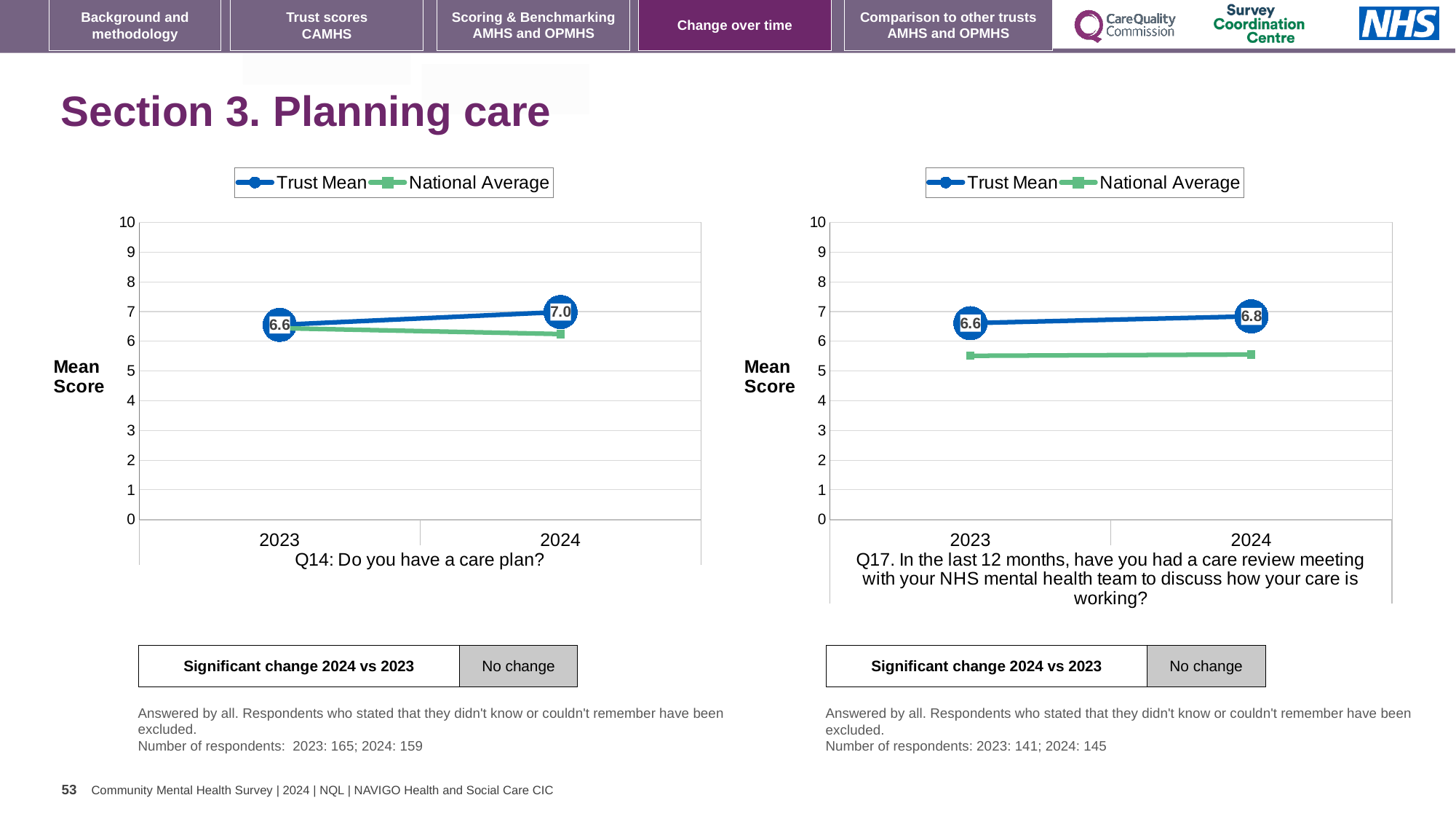
In the left chart (Q14: Do you have a care plan?), what is the Trust Mean for 2024? 7.0 In the right chart (Q17, care review meeting), what is the Trust Mean for 2023? 6.6 In the right chart (Q17), by how much did the Trust Mean change from 2023 to 2024? 0.2 In the right chart (Q17), is the National Average for 2024 greater or less than 6? less In the left chart (Q14), does the Trust Mean rise or fall from 2023 to 2024? rise What kind of chart is the left chart (Q14)? line chart How many years are plotted on the x axis of the left chart (Q14)? 2 In the right chart (Q17), is the Trust Mean for 2024 greater or less than the National Average for 2024? greater In the right chart (Q17, care review meeting), what is the Trust Mean for 2024? 6.8 In the left chart (Q14), by how much did the Trust Mean change from 2023 to 2024? 0.4 How many series does the legend of the right chart (Q17) list? 2 In the left chart (Q14: Do you have a care plan?), what is the Trust Mean for 2023? 6.6